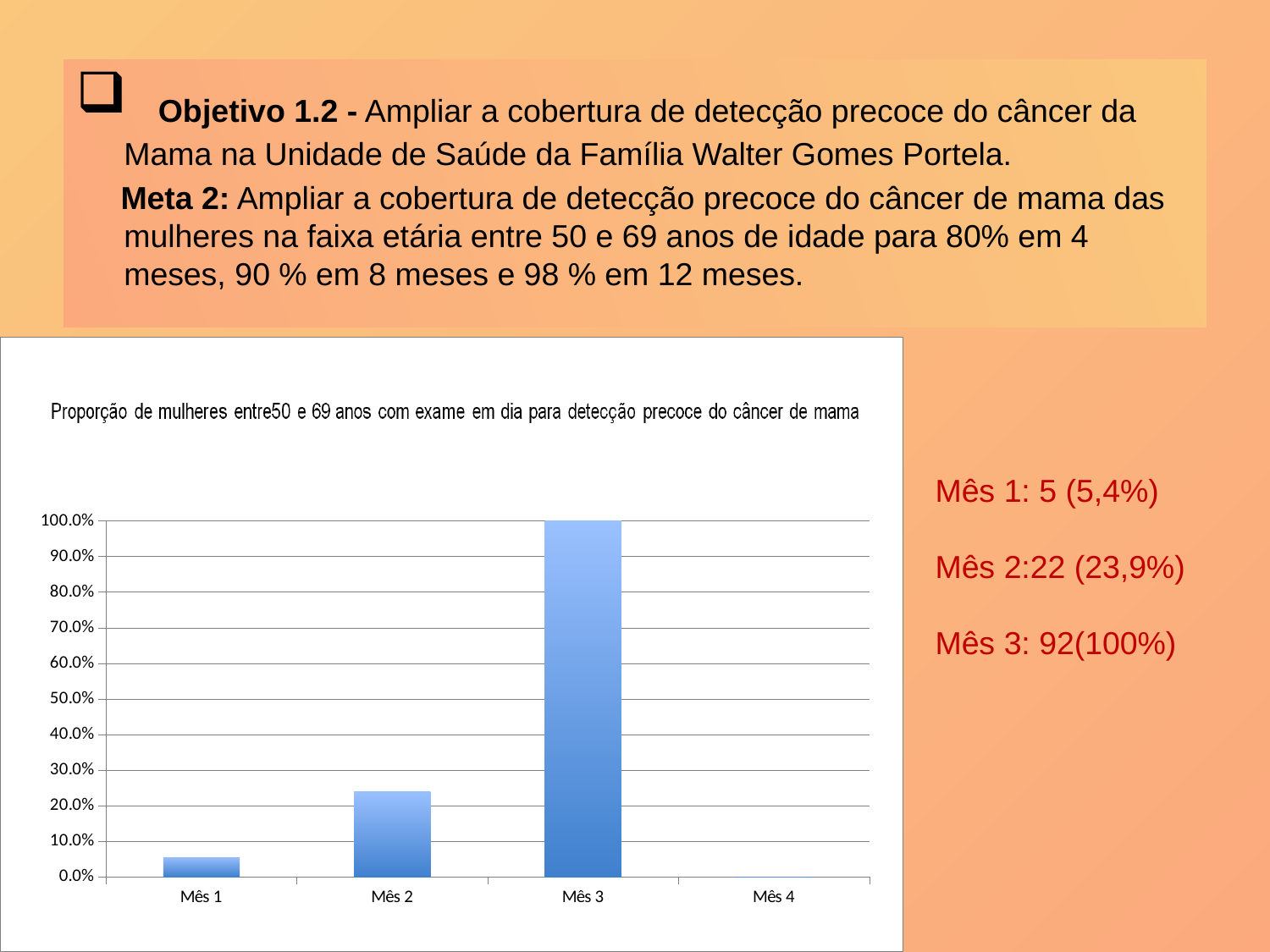
Which is larger, the value for Mês 1 or the value for Mês 2? Mês 2 Is the value for Mês 1 greater or less than 10.0%? less What is the value for Mês 3 in the chart? 100.0% What is the title of the chart? Proporção de mulheres entre50 e 69 anos com exame em dia para detecção precoce do câncer de mama Do the values rise or fall from Mês 1 to Mês 3? rise Which month has the highest value in the chart? Mês 3 What kind of chart is shown on the slide? bar chart Is the value for Mês 2 greater or less than 30.0%? less What is the highest tick value shown on the y axis of the chart? 100.0% Which month has the lowest value in the chart? Mês 4 Is the value for Mês 2 greater or less than 20.0%? greater How many categories are shown on the x axis of the chart? 4